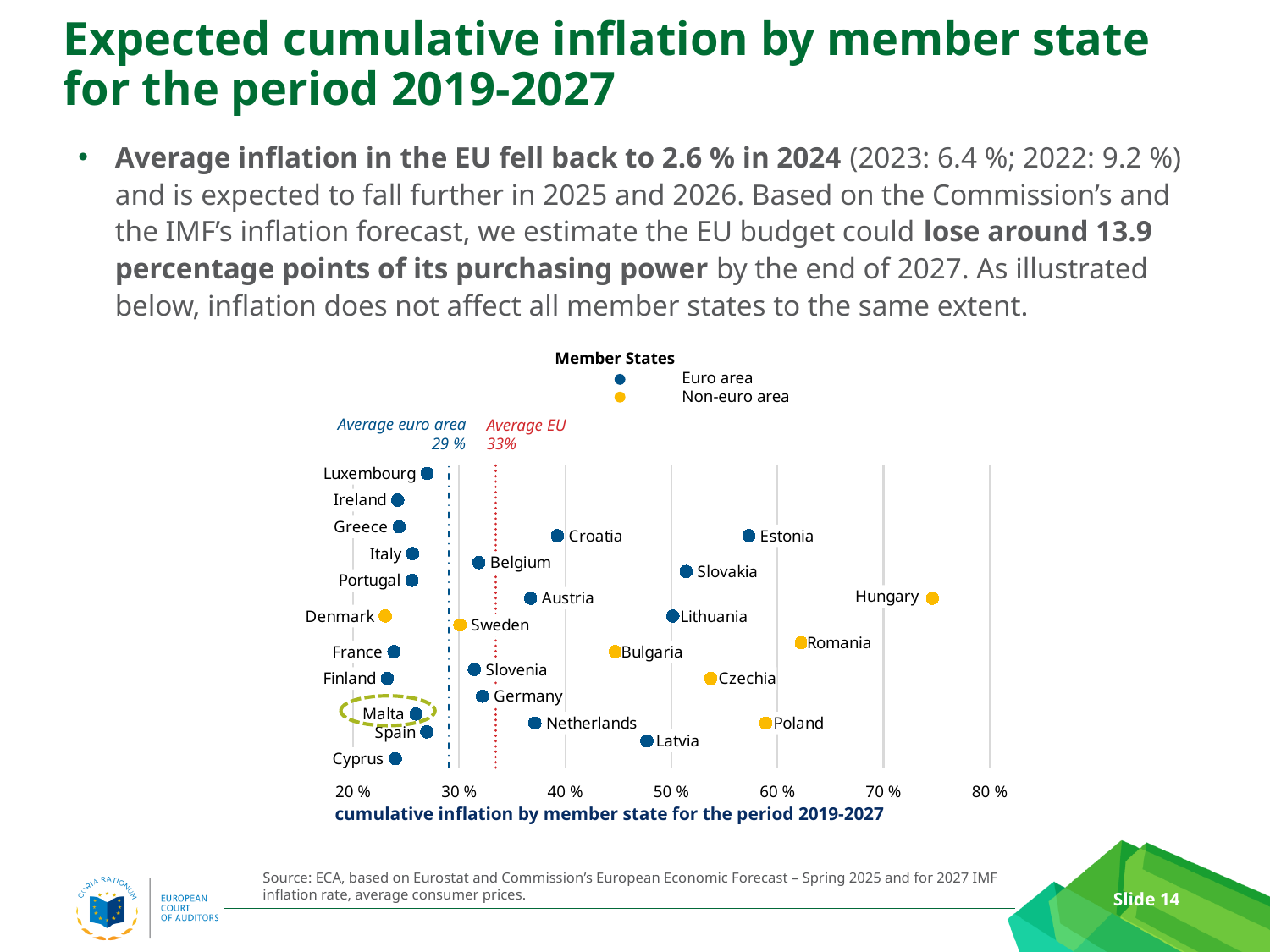
What is the average euro area cumulative inflation shown on the chart? 29 % Is the value for Latvia greater or less than 50 %? less How many series does the legend list? 2 What is the average EU cumulative inflation shown on the chart? 33% How many member states are plotted on the chart? 27 Which member state has the highest expected cumulative inflation for 2019-2027? Hungary How many non-euro area member states are plotted on the chart? 7 Is the value for Austria greater or less than 40 %? less Is the value for Hungary greater or less than 70 %? greater Which has the higher cumulative inflation, Romania or Hungary? Hungary Which member state is highlighted with a dashed circle on the chart? Malta What kind of chart is shown on the slide? Scatter (dot) chart